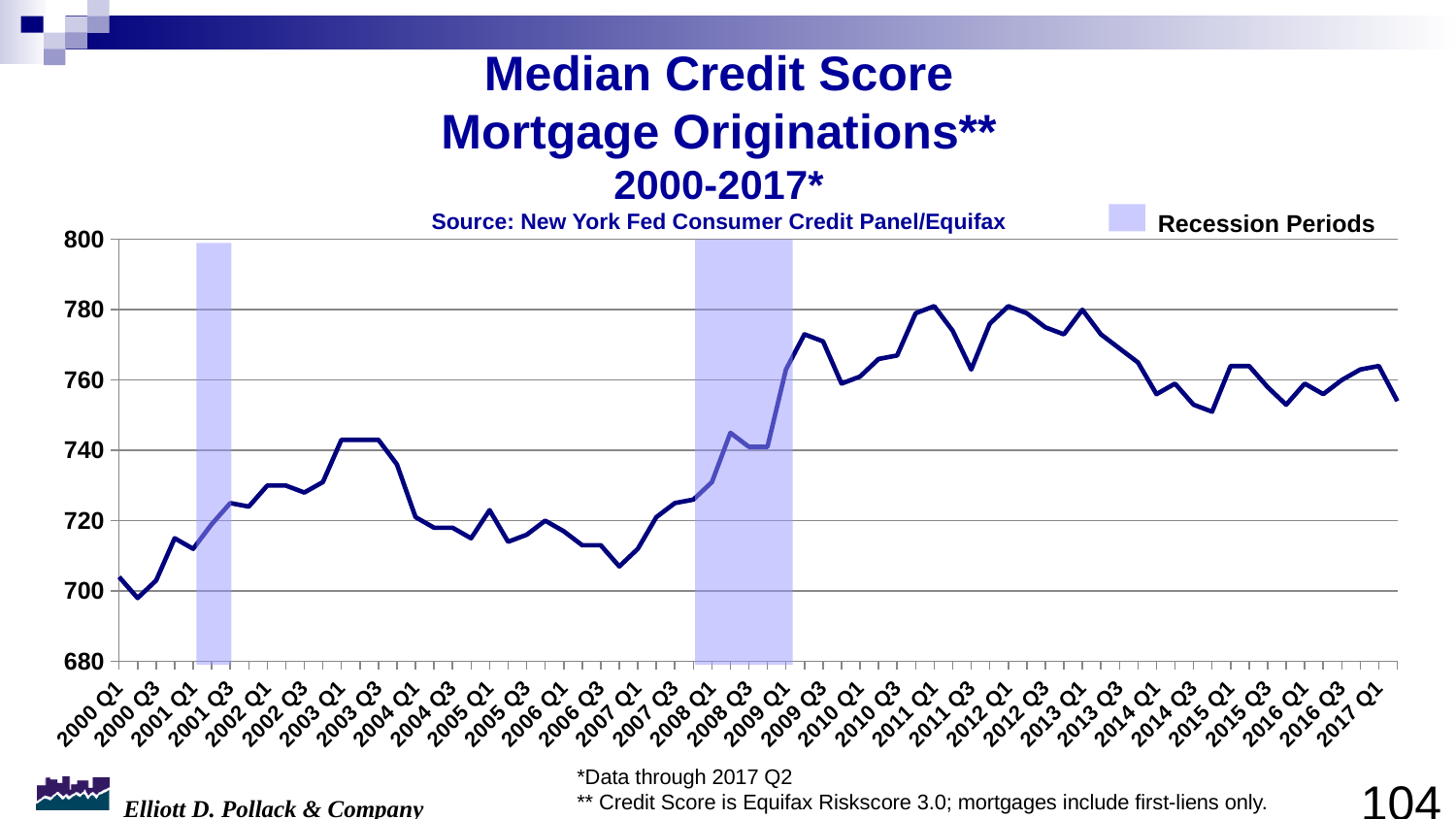
Is the median credit score for 2007 Q1 greater or less than 720? less Is the median credit score for 2009 Q3 greater or less than 760? greater Does the median credit score rise or fall between 2007 Q1 and 2009 Q3? rise What kind of chart is shown on the slide? line chart What do the shaded vertical bands on the chart represent? Recession Periods Is the median credit score for 2015 Q1 greater or less than 740? greater What is the title of the chart? Median Credit Score Mortgage Originations** 2000-2017* Which is higher, the median credit score in 2003 Q3 or in 2005 Q1? 2003 Q3 Does the median credit score rise or fall overall between 2013 Q1 and 2015 Q1? fall